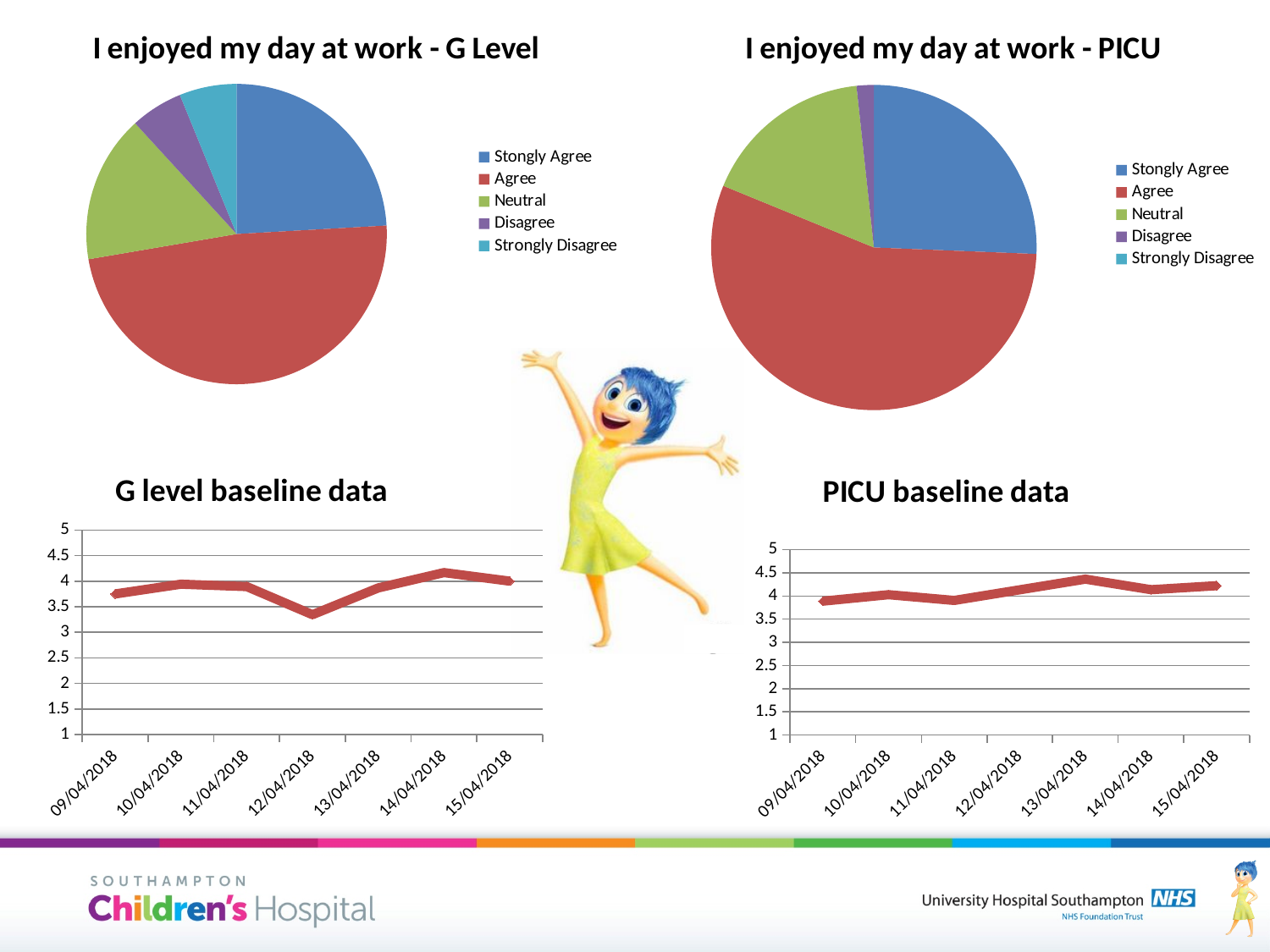
In the 'I enjoyed my day at work - G Level' chart, which response has the largest slice? Agree How many dates are shown on the x axis of the 'G level baseline data' chart? 7 In the 'I enjoyed my day at work - PICU' chart, which visible response has the smallest slice? Disagree In the 'I enjoyed my day at work - PICU' chart, which response has the largest slice? Agree How many entries does the legend of the 'I enjoyed my day at work - PICU' chart list? 5 In the 'G level baseline data' chart, is the value for 14/04/2018 greater or less than 4? greater In the 'PICU baseline data' chart, is the value for 09/04/2018 greater or less than 4.5? less What kind of chart is 'G level baseline data'? Line chart In the 'G level baseline data' chart, which date has the highest value? 14/04/2018 In the 'G level baseline data' chart, which date has the lowest value? 12/04/2018 What kind of chart is 'I enjoyed my day at work - G Level'? Pie chart